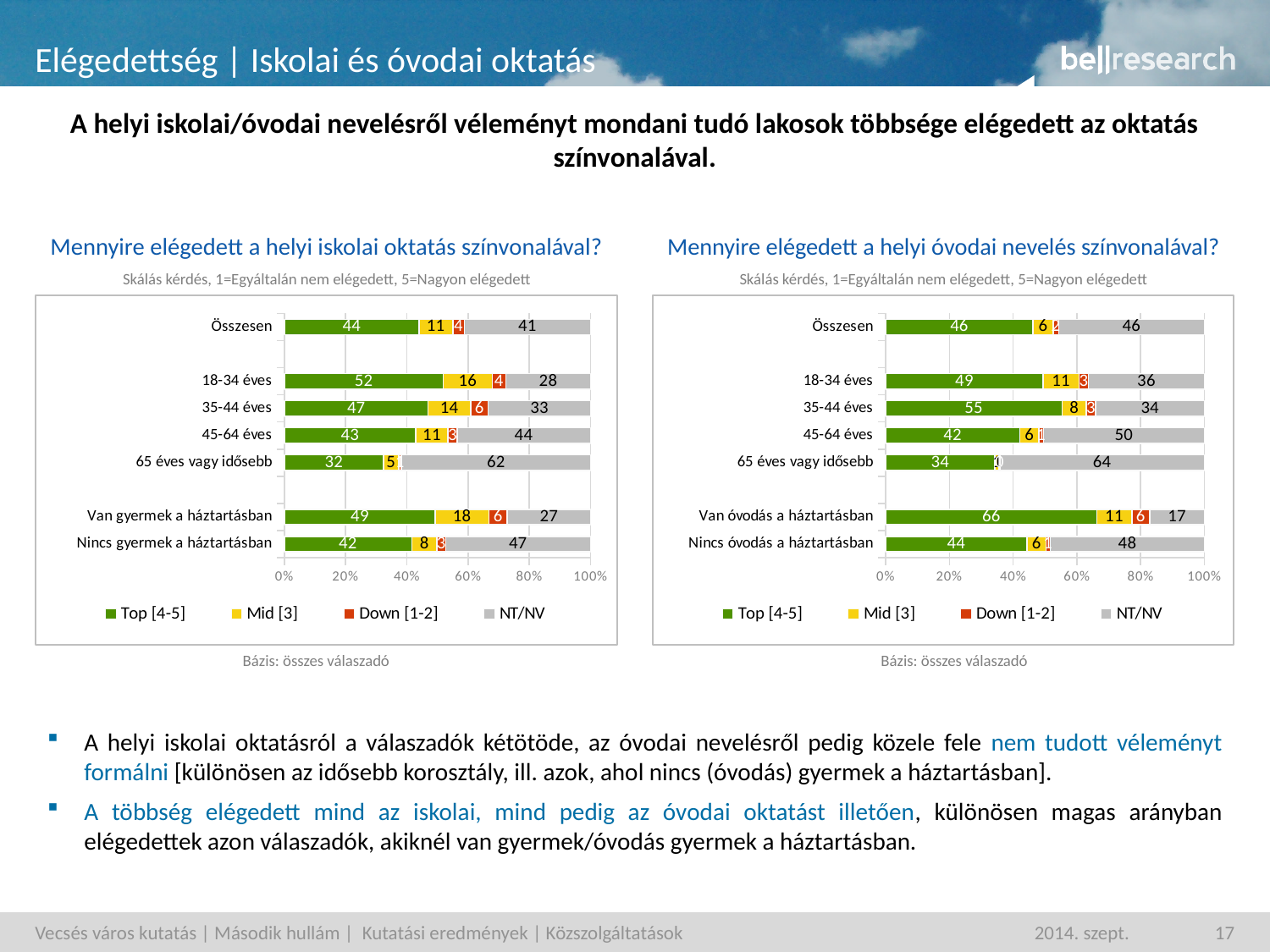
In the right chart (óvodai nevelés), what is the difference between the NT/NV values for Van óvodás a háztartásban and Nincs óvodás a háztartásban? 31 How many categories are shown in the right chart (óvodai nevelés)? 7 In the right chart (óvodai nevelés), which category has the lowest Top [4-5] value? 65 éves vagy idősebb In the left chart (iskolai oktatás), what is the difference between the Top [4-5] values for Van gyermek a háztartásban and Nincs gyermek a háztartásban? 7 In the left chart (Mennyire elégedett a helyi iskolai oktatás színvonalával?), what is the Top [4-5] value for Összesen? 44 In the right chart (óvodai nevelés), what is the NT/NV value for 45-64 éves? 50 In the right chart (Mennyire elégedett a helyi óvodai nevelés színvonalával?), what is the Top [4-5] value for Van óvodás a háztartásban? 66 In the right chart (óvodai nevelés), which is larger: the Mid [3] value for 18-34 éves or for 35-44 éves? 18-34 éves In the left chart (iskolai oktatás), which category has the highest Top [4-5] value? 18-34 éves How many series does the legend of the left chart list? 4 What type of chart is used on the left side of the slide? Stacked bar chart In the left chart (iskolai oktatás), what is the NT/NV value for 65 éves vagy idősebb? 62